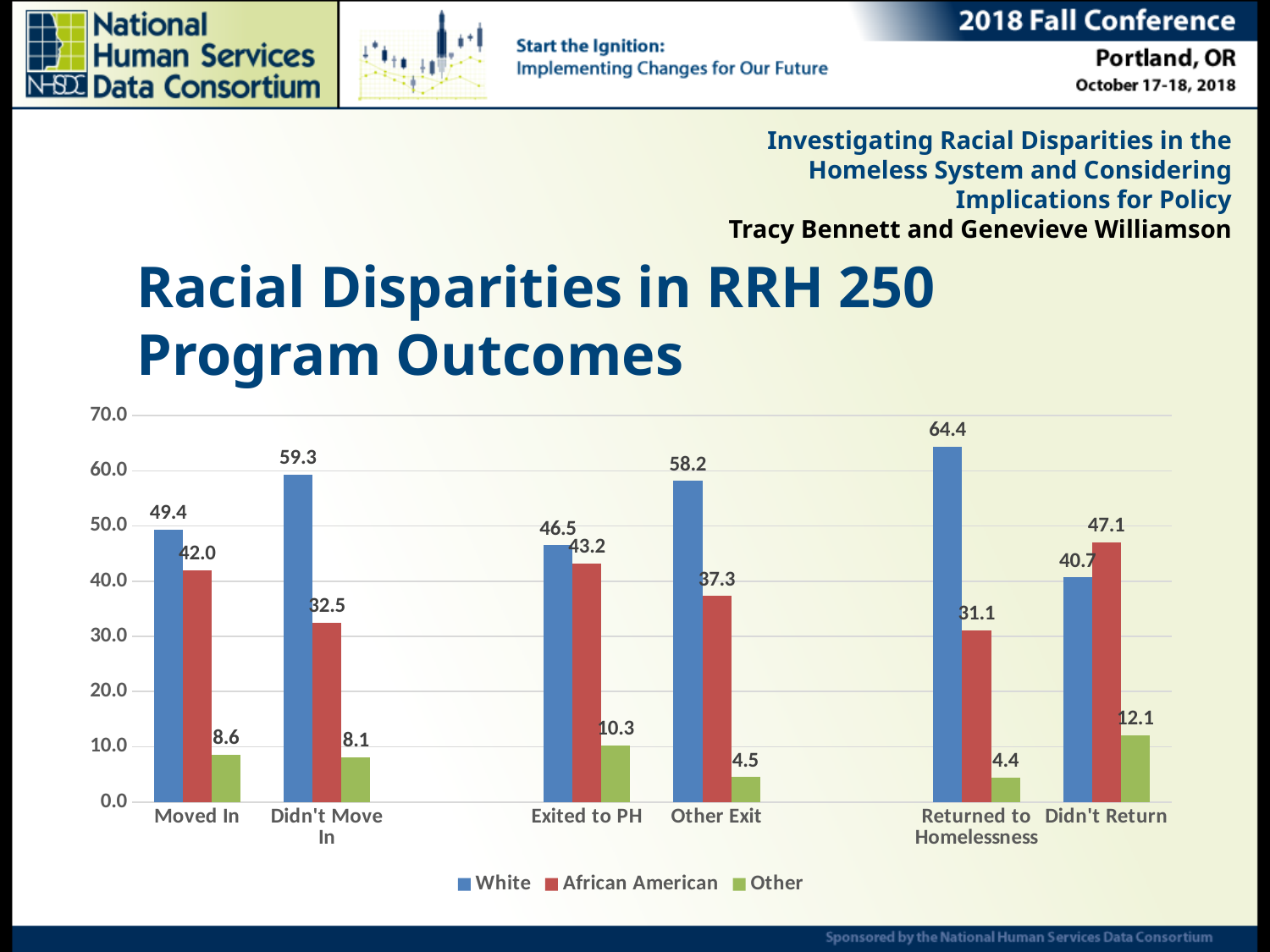
How many series does the legend list? 3 What is the value for Other in the Exited to PH category? 10.3 Which colour represents the African American series? red Which category has the highest value for the White series? Returned to Homelessness What is the difference between the White and African American values in the Didn't Move In category? 26.8 What is the value for African American in the Didn't Return category? 47.1 Which is larger in the Didn't Return category, the White value or the African American value? African American Which category has the lowest value for the Other series? Returned to Homelessness What is the value for White in the Moved In category? 49.4 What kind of chart is shown on the slide? bar chart How many categories are shown on the x axis? 6 Is the value for White in the Other Exit category greater or less than 50.0? greater